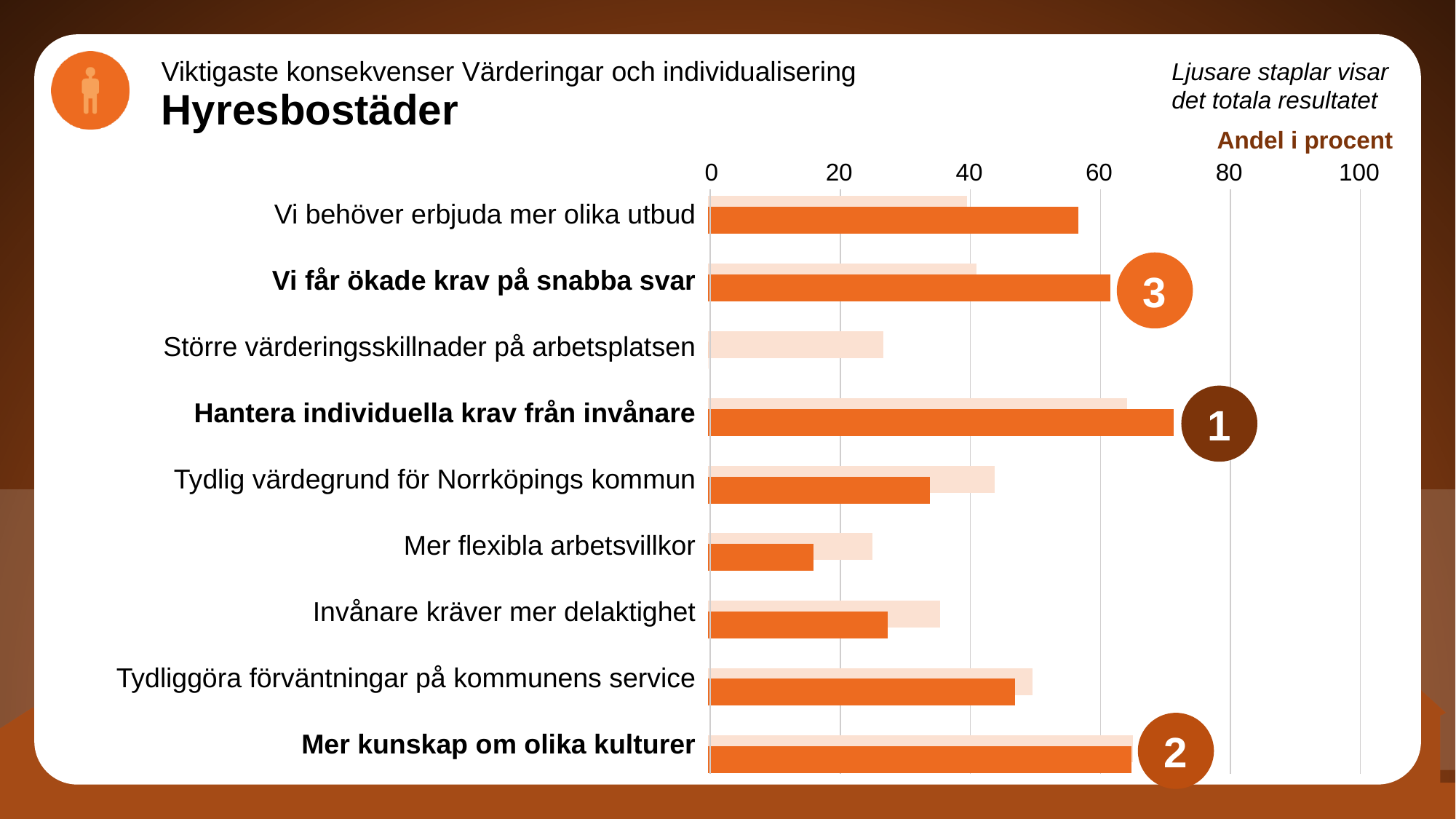
Is the dark orange bar for 'Vi behöver erbjuda mer olika utbud' greater or less than 40? greater Which category is marked with the number 1 badge? Hantera individuella krav från invånare For 'Tydlig värdegrund för Norrköpings kommun', which bar is longer: the dark orange bar or the lighter bar? the lighter bar Is the dark orange bar for 'Tydlig värdegrund för Norrköpings kommun' greater or less than 40? less What is the label shown above the horizontal axis? Andel i procent Which has a longer dark orange bar: 'Vi får ökade krav på snabba svar' or 'Tydlig värdegrund för Norrköpings kommun'? Vi får ökade krav på snabba svar What kind of chart is shown on the slide? bar chart Is the dark orange bar for 'Mer flexibla arbetsvillkor' greater or less than 20? less Which category has the longest dark orange bar? Hantera individuella krav från invånare How many categories are listed on the chart? 9